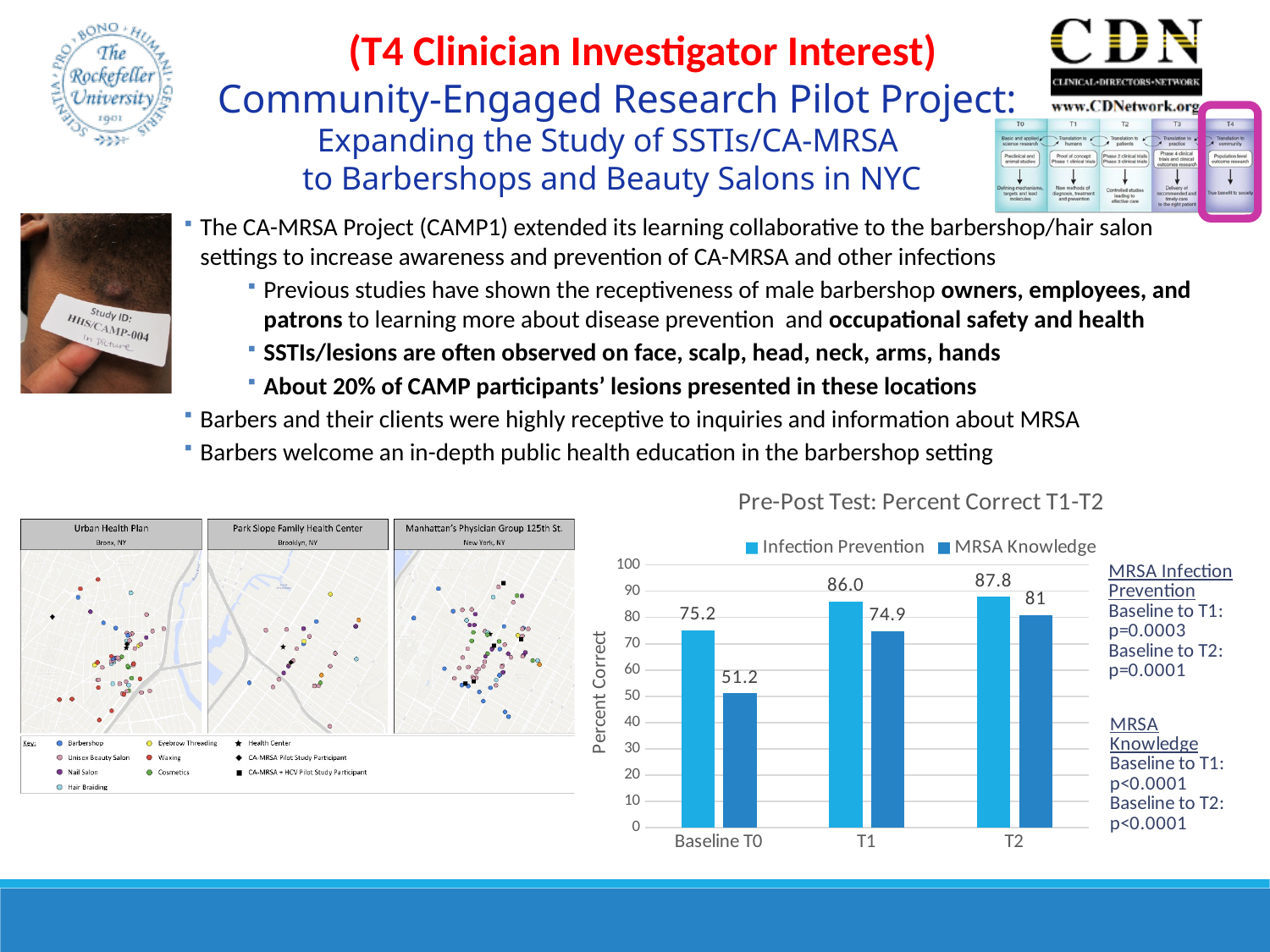
How many categories are shown on the x axis of the chart? 3 Do the MRSA Knowledge values rise or fall from Baseline T0 to T2? rise Which is larger at T1: Infection Prevention or MRSA Knowledge? Infection Prevention What is the MRSA Knowledge value at T2? 81 What is the title of the chart on the slide? Pre-Post Test: Percent Correct T1-T2 How many series does the chart legend list? 2 At which time point is the MRSA Knowledge value lowest? Baseline T0 What is the difference between the Infection Prevention and MRSA Knowledge values at Baseline T0? 24 What is the MRSA Knowledge value at T1? 74.9 What type of chart is shown on the slide? bar chart What is the Infection Prevention value at Baseline T0? 75.2 At which time point is the Infection Prevention value highest? T2